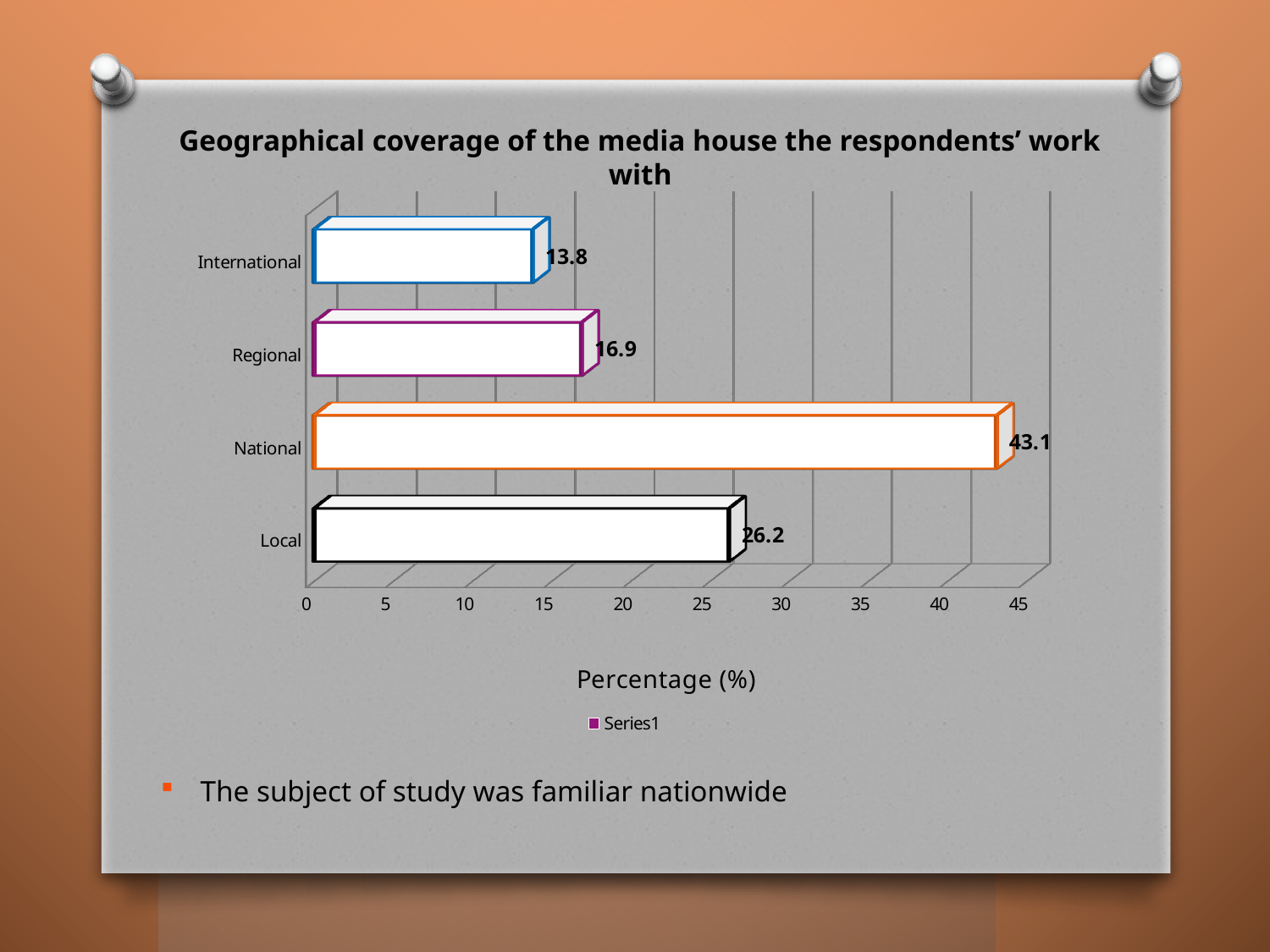
How many categories are shown on the chart? 4 Which is larger, the value for Local or the value for Regional? Local What is the difference between the values for National and Local? 16.9 What is the difference between the values for Regional and International? 3.1 What is the value for Local? 26.2 Which category has the highest value? National What is the label of the horizontal axis? Percentage (%) What is the value for National? 43.1 What kind of chart is shown on the slide? Bar chart Which category has the lowest value? International What is the value for Regional? 16.9 What is the value for International? 13.8